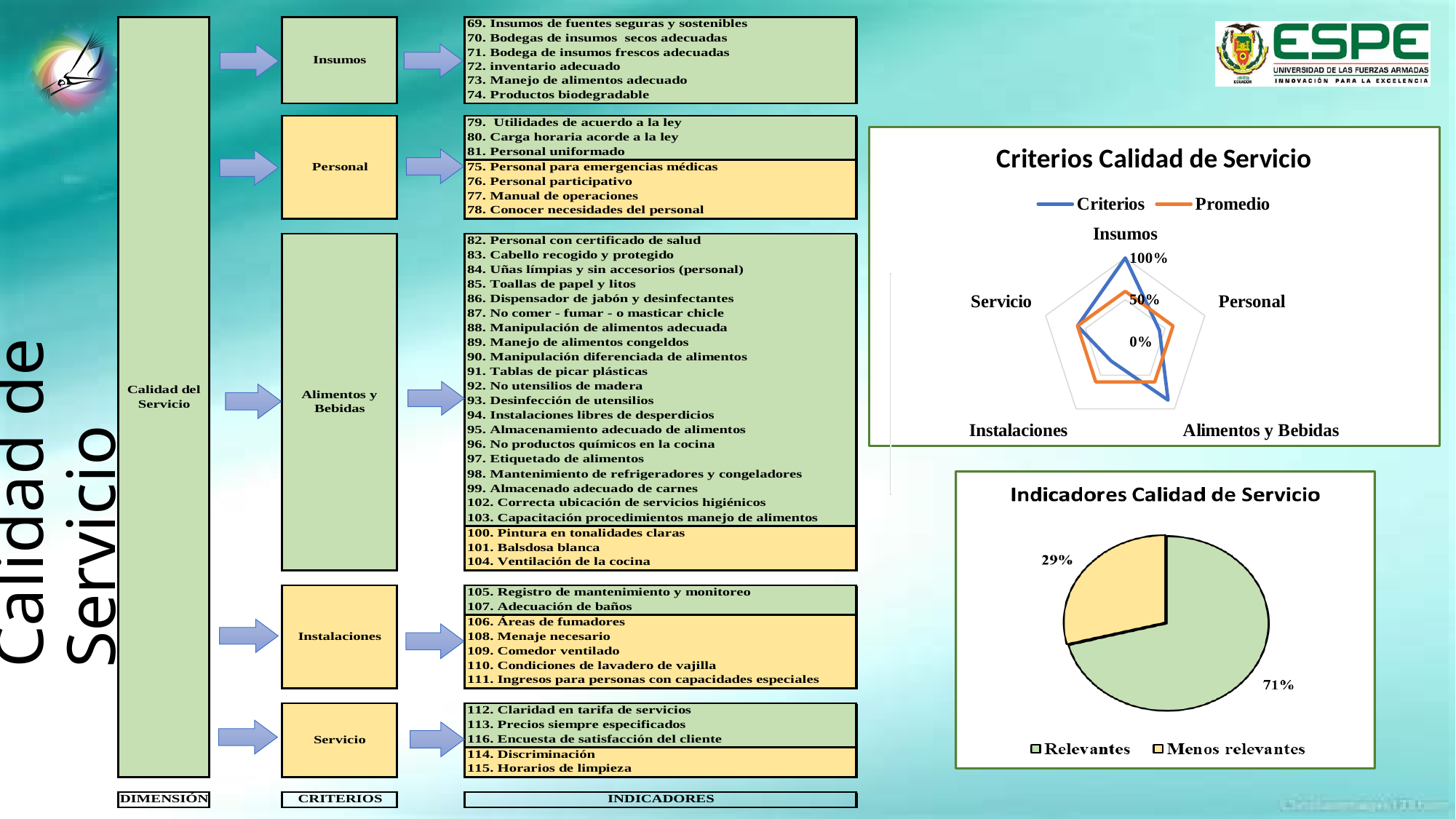
In the 'Indicadores Calidad de Servicio' chart, which slice is larger, Relevantes or Menos relevantes? Relevantes In the 'Indicadores Calidad de Servicio' chart, what share is labelled for Menos relevantes? 29% In the 'Criterios Calidad de Servicio' chart, is the Criterios value for Insumos greater or less than 50%? greater In the 'Indicadores Calidad de Servicio' chart, what is the difference in percentage points between Relevantes and Menos relevantes? 42 percentage points In the 'Criterios Calidad de Servicio' chart, how many series does the legend list? 2 In the 'Criterios Calidad de Servicio' chart, which series is drawn in orange? Promedio What kind of chart is 'Indicadores Calidad de Servicio'? Pie chart What kind of chart is 'Criterios Calidad de Servicio'? Radar chart In the 'Criterios Calidad de Servicio' chart, how many categories (axes) are shown? 5 In the 'Indicadores Calidad de Servicio' chart, how many slices does the pie have? 2 In the 'Indicadores Calidad de Servicio' chart, which slice is coloured yellow? Menos relevantes In the 'Indicadores Calidad de Servicio' chart, what share is labelled for Relevantes? 71%